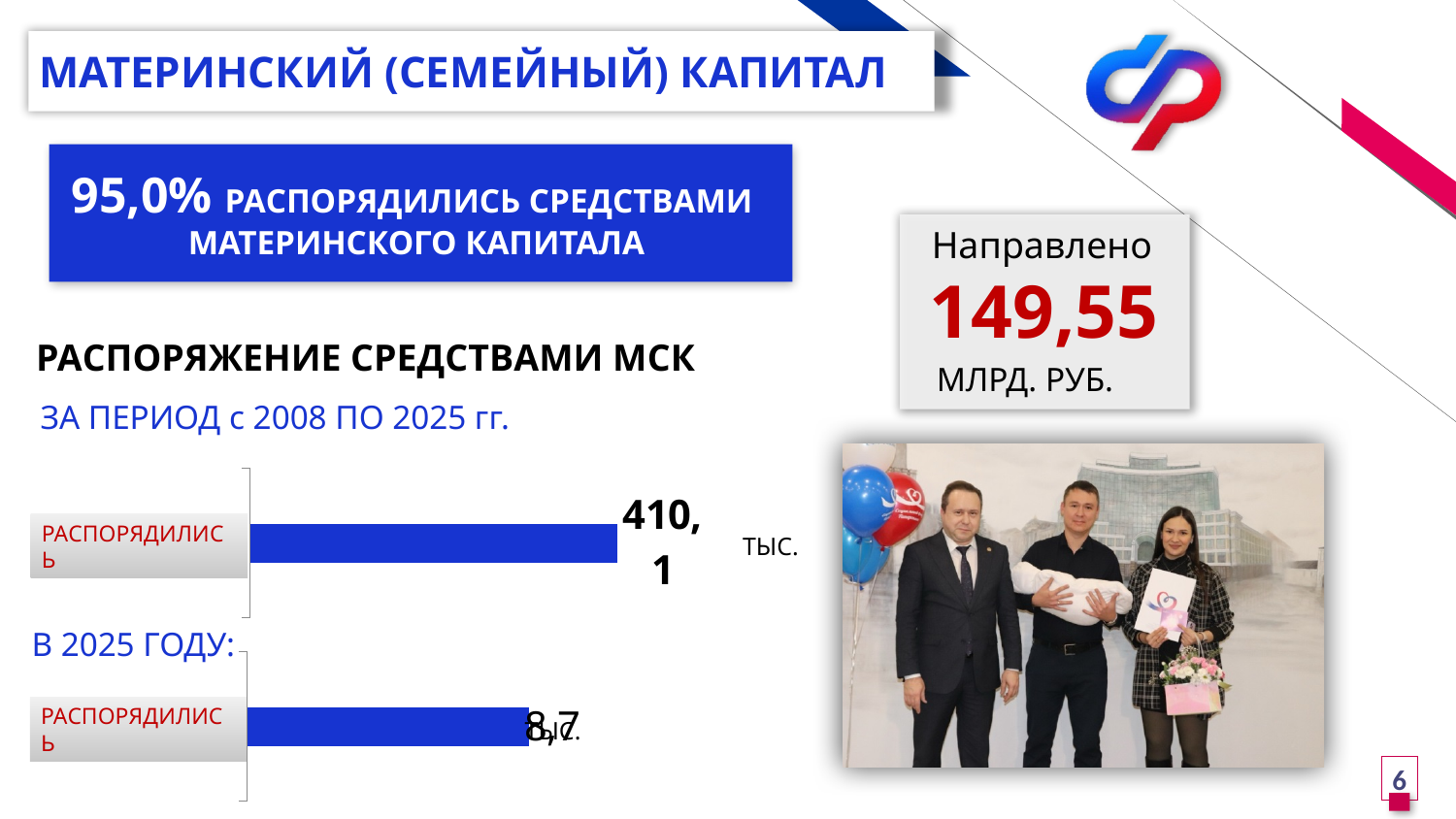
What kind of chart is used for the 2025 data (В 2025 ГОДУ)? Bar chart What is the difference between the РАСПОРЯДИЛИСЬ value in the 2008–2025 chart (410,1) and the value in the 2025 chart (8,7)? 401,4 In the chart for 2025 (В 2025 ГОДУ), what value is shown for the bar labelled РАСПОРЯДИЛИСЬ? 8,7 In the chart for the period 2008 to 2025, what value is shown for the bar labelled РАСПОРЯДИЛИСЬ? 410,1 What kind of chart is used for the period 2008 to 2025 data? Bar chart How many bars are plotted in the chart for the period 2008 to 2025? 1 What unit is shown next to the bar value in the chart for the period 2008 to 2025? тыс. What colour are the bars in the two charts on the slide? Blue Are the bars in the chart for the period 2008 to 2025 horizontal or vertical? Horizontal Which is larger: the РАСПОРЯДИЛИСЬ value in the 2008–2025 chart or the РАСПОРЯДИЛИСЬ value in the 2025 chart? The 2008–2025 chart (410,1) How many bars are plotted in the chart for 2025 (В 2025 ГОДУ)? 1